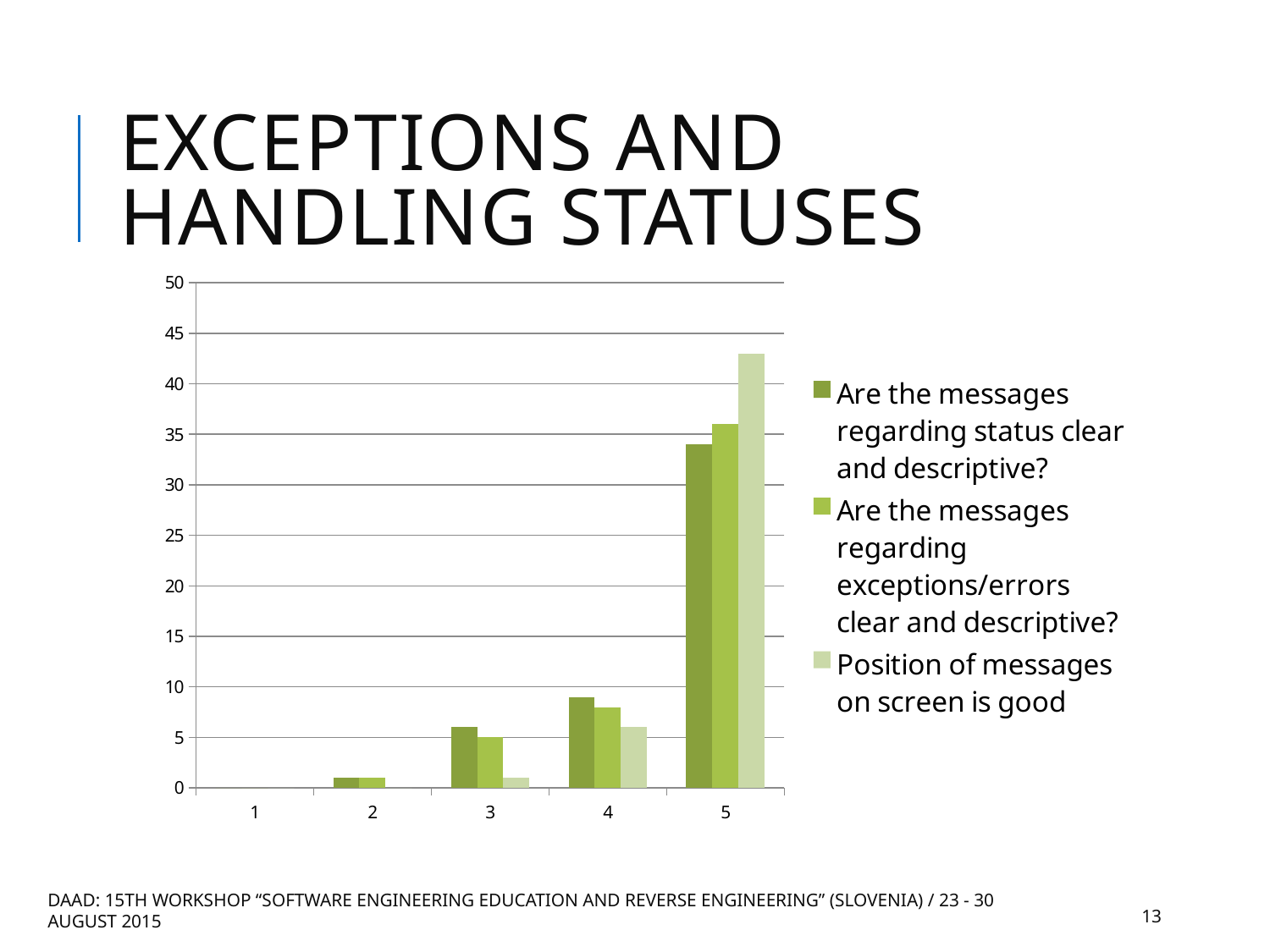
Is the value for "Position of messages on screen is good" at category 5 greater or less than 40? greater Is the value for "Are the messages regarding status clear and descriptive?" at category 5 greater or less than 30? greater How many categories are shown on the x axis? 5 Which category has the highest value for "Position of messages on screen is good"? 5 At category 4, which is larger: "Are the messages regarding status clear and descriptive?" or "Position of messages on screen is good"? Are the messages regarding status clear and descriptive? What kind of chart is shown on the slide? bar chart Is the value for "Are the messages regarding exceptions/errors clear and descriptive?" at category 3 greater or less than 10? less Do the values for "Position of messages on screen is good" rise or fall from category 1 to category 5? rise Which category has the highest value for "Are the messages regarding status clear and descriptive?"? 5 How many series does the legend list? 3 At category 5, which is larger: "Position of messages on screen is good" or "Are the messages regarding status clear and descriptive?"? Position of messages on screen is good